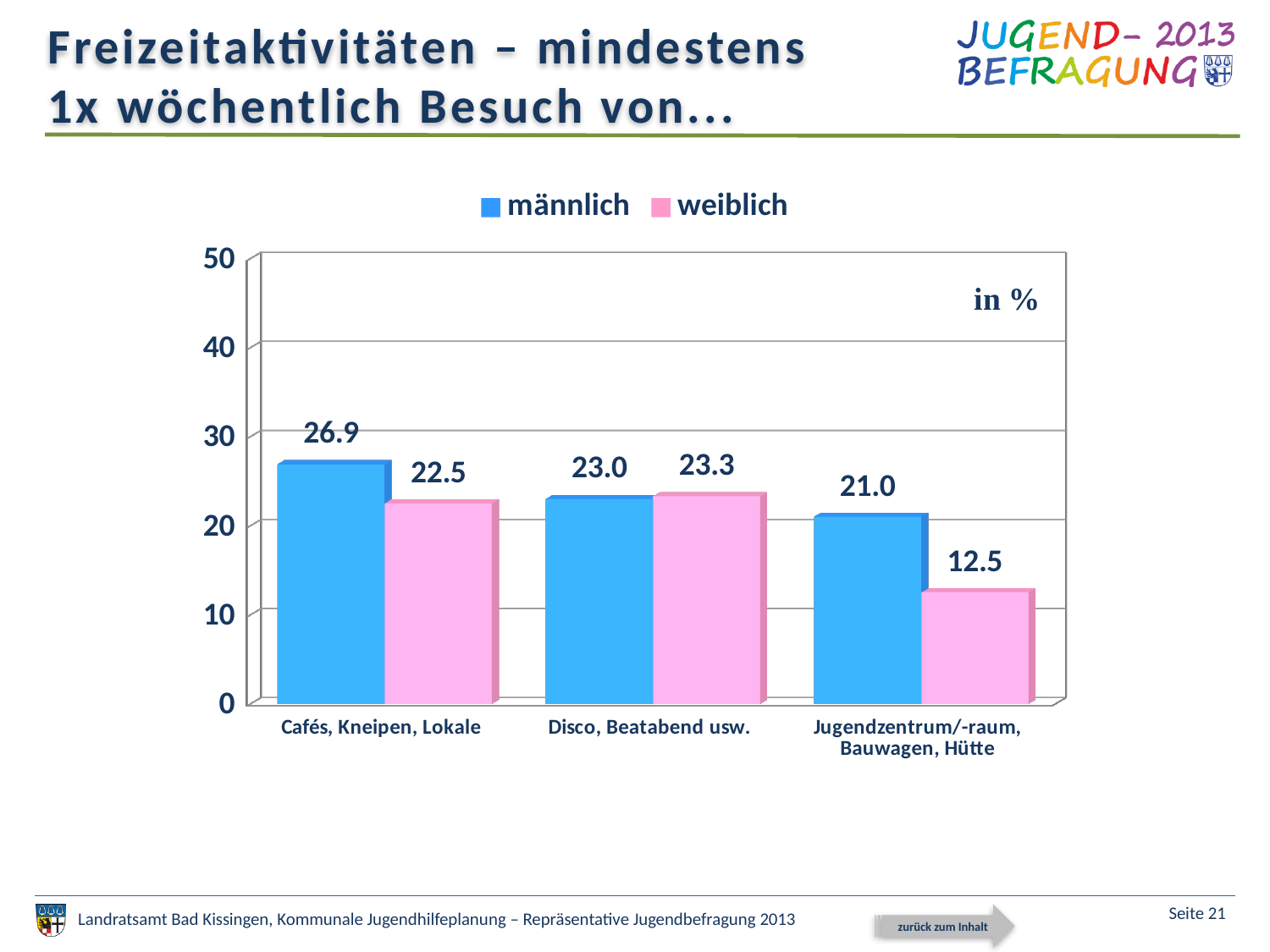
What kind of chart is shown on the slide? bar chart Is the weiblich value for Jugendzentrum/-raum, Bauwagen, Hütte greater or less than 20? less What is the difference between the männlich and weiblich values for Jugendzentrum/-raum, Bauwagen, Hütte? 8.5 How many series does the legend list? 2 Which is larger for Cafés, Kneipen, Lokale: the männlich value or the weiblich value? männlich How many categories are shown on the x axis? 3 What is the value for weiblich in the Jugendzentrum/-raum, Bauwagen, Hütte category? 12.5 What is the value for männlich in the Cafés, Kneipen, Lokale category? 26.9 Which category has the lowest weiblich value? Jugendzentrum/-raum, Bauwagen, Hütte Which category has the highest männlich value? Cafés, Kneipen, Lokale Which colour represents the weiblich series? pink What is the value for weiblich in the Disco, Beatabend usw. category? 23.3